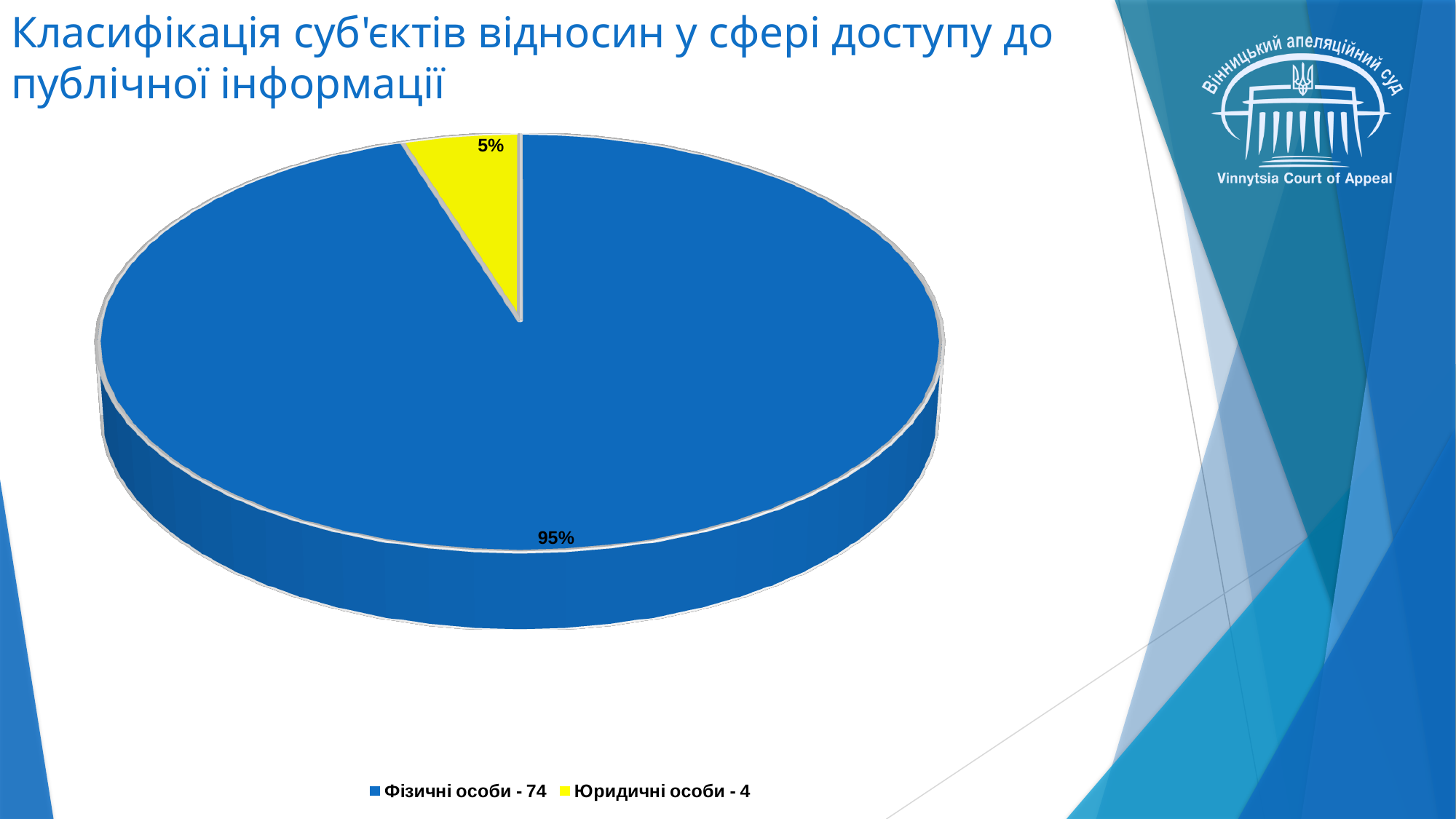
Which category has the smallest slice of the pie? Юридичні особи - 4 What share of the pie does "Фізичні особи - 74" represent? 95% What is the difference in percentage points between the "Фізичні особи - 74" slice and the "Юридичні особи - 4" slice? 90 percentage points What colour is the slice for "Фізичні особи - 74"? blue What colour is the slice for "Юридичні особи - 4"? yellow How many slices does the pie chart have? 2 What share of the pie does "Юридичні особи - 4" represent? 5% What kind of chart is shown on the slide? pie chart Which slice is larger: "Фізичні особи - 74" or "Юридичні особи - 4"? Фізичні особи - 74 Which category has the largest slice of the pie? Фізичні особи - 74 How many entries does the legend list? 2